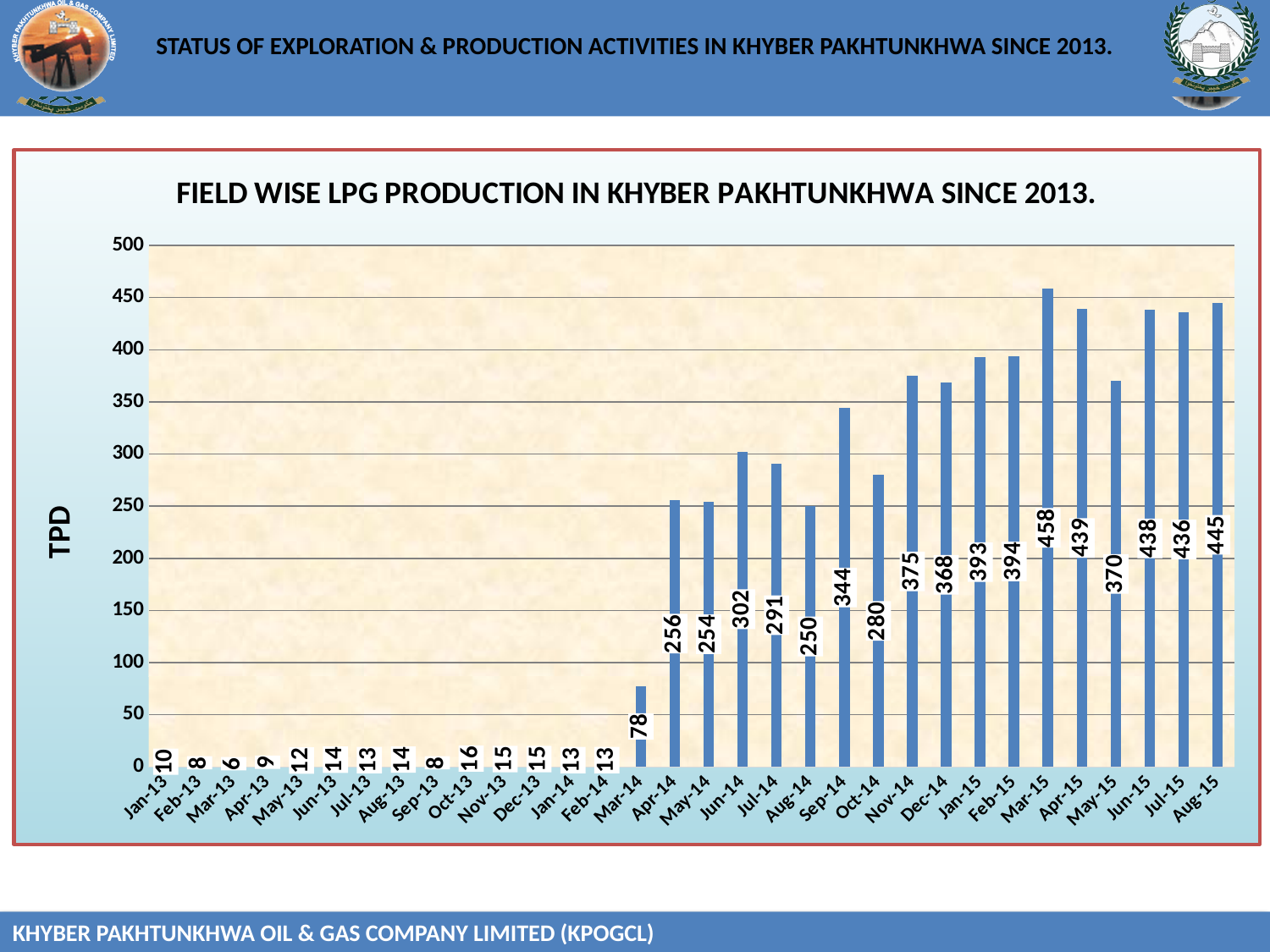
What is the LPG production value for Sep-14? 344 How many months are plotted on the chart? 32 Which month has higher LPG production, Jun-14 or Jul-14? Jun-14 Which month has the highest LPG production? Mar-15 What is the label on the vertical axis of the chart? TPD What is the LPG production value for Mar-14? 78 Is the value for Aug-15 greater or less than 400? greater What is the LPG production value for Oct-13? 16 What kind of chart is shown on the slide? bar chart Which month has the lowest LPG production? Mar-13 What is the difference between the LPG production in Mar-15 and Apr-15? 19 What is the difference between the LPG production in Jun-14 and Aug-14? 52